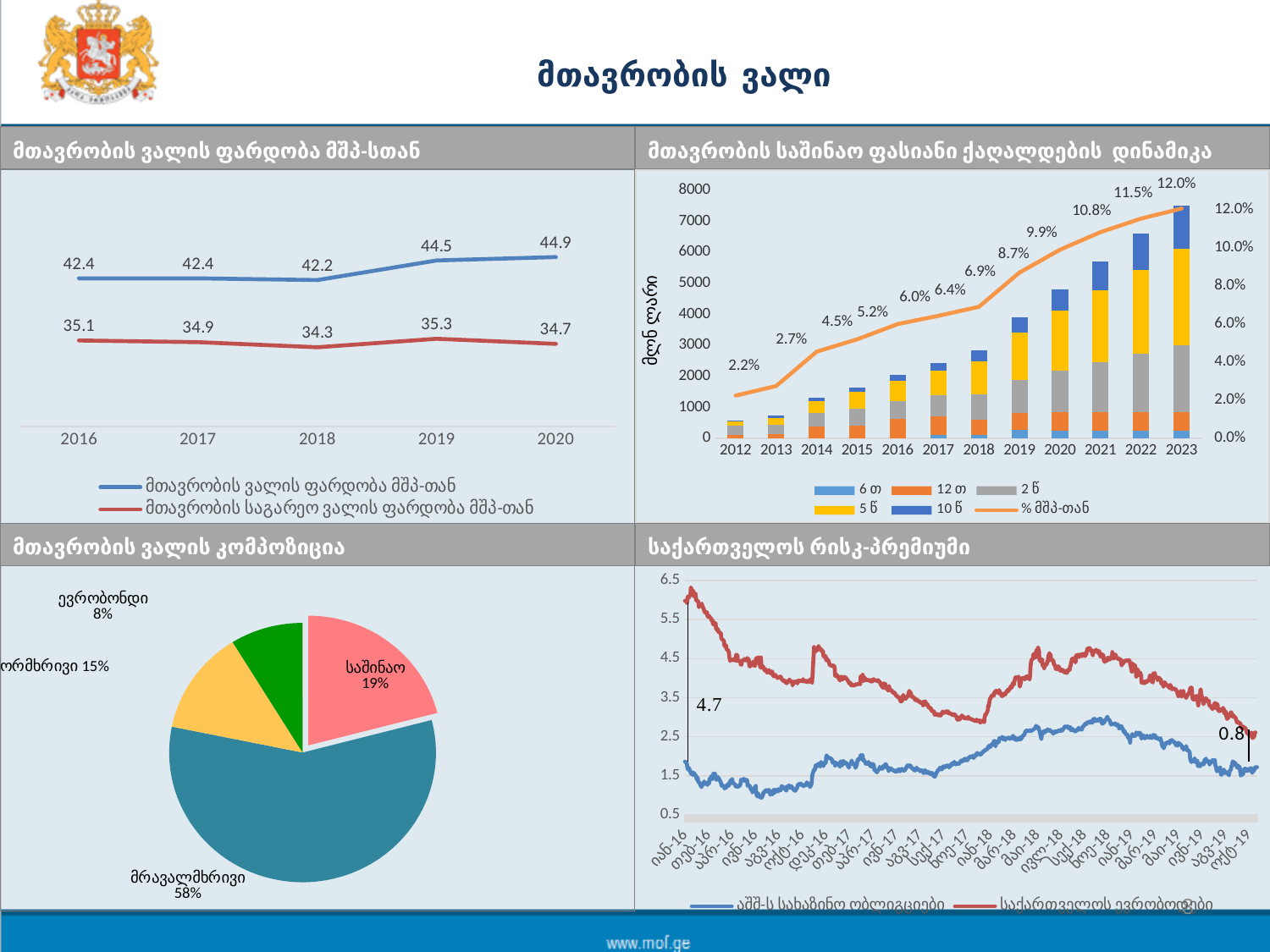
In the bottom-left pie chart (მთავრობის ვალის კომპოზიცია), which slice is the smallest? ევრობონდი In the top-left chart (მთავრობის ვალის ფარდობა მშპ-სთან), what is the value of the blue series (მთავრობის ვალის ფარდობა მშპ-თან) for 2020? 44.9 In the top-right chart (მთავრობის საშინაო ფასიანი ქაღალდების დინამიკა), what is the % მშპ-თან value for 2023? 12.0% How many years are shown on the x axis of the top-left chart (მთავრობის ვალის ფარდობა მშპ-სთან)? 5 In the top-right chart (მთავრობის საშინაო ფასიანი ქაღალდების დინამიკა), what is the % მშპ-თან value for 2012? 2.2% In the top-left chart (მთავრობის ვალის ფარდობა მშპ-სთან), what is the difference between the blue and red series values in 2019? 9.2 In the bottom-left pie chart (მთავრობის ვალის კომპოზიცია), what share does მრავალმხრივი have? 58% In the top-right chart (მთავრობის საშინაო ფასიანი ქაღალდების დინამიკა), does the % მშპ-თან line rise or fall from 2012 to 2023? rise In the top-left chart (მთავრობის ვალის ფარდობა მშპ-სთან), what is the value of the red series (მთავრობის საგარეო ვალის ფარდობა მშპ-თან) for 2018? 34.3 In the top-left chart (მთავრობის ვალის ფარდობა მშპ-სთან), in which year is the blue series (მთავრობის ვალის ფარდობა მშპ-თან) highest? 2020 How many entries does the legend of the top-right chart (მთავრობის საშინაო ფასიანი ქაღალდების დინამიკა) list? 6 What type of chart is the bottom-right chart (საქართველოს რისკ-პრემიუმი)? line chart